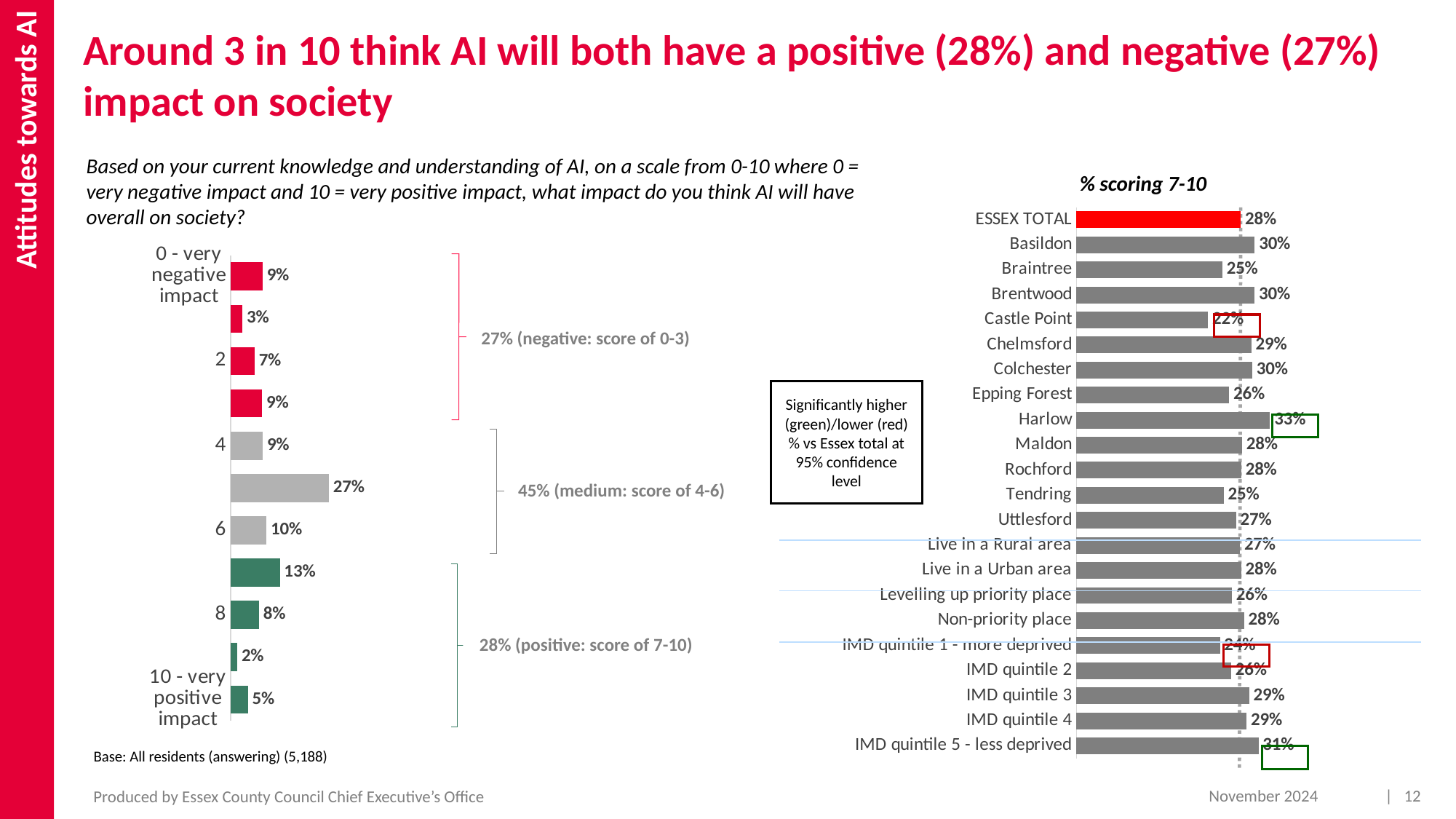
In the '% scoring 7-10' chart, how many categories are plotted? 22 In the '% scoring 7-10' chart, what is the difference between Harlow and ESSEX TOTAL? 5% In the left chart, what percentage gave a score of 10 (very positive impact)? 5% What type of chart is the '% scoring 7-10' chart? Bar chart In the left chart, what percentage gave a score of 6? 10% In the '% scoring 7-10' chart, which has the higher value, Basildon or Braintree? Basildon In the left chart, what is the difference between the percentage scoring 8 and the percentage scoring 2? 1% In the left chart, what is the highest percentage shown for any single score? 27% In the '% scoring 7-10' chart, which area has the lowest value? Castle Point In the '% scoring 7-10' chart, what is the value for Harlow? 33% In the left chart, what percentage gave a score of 0 (very negative impact)? 9% In the left chart, how many bars are plotted? 11